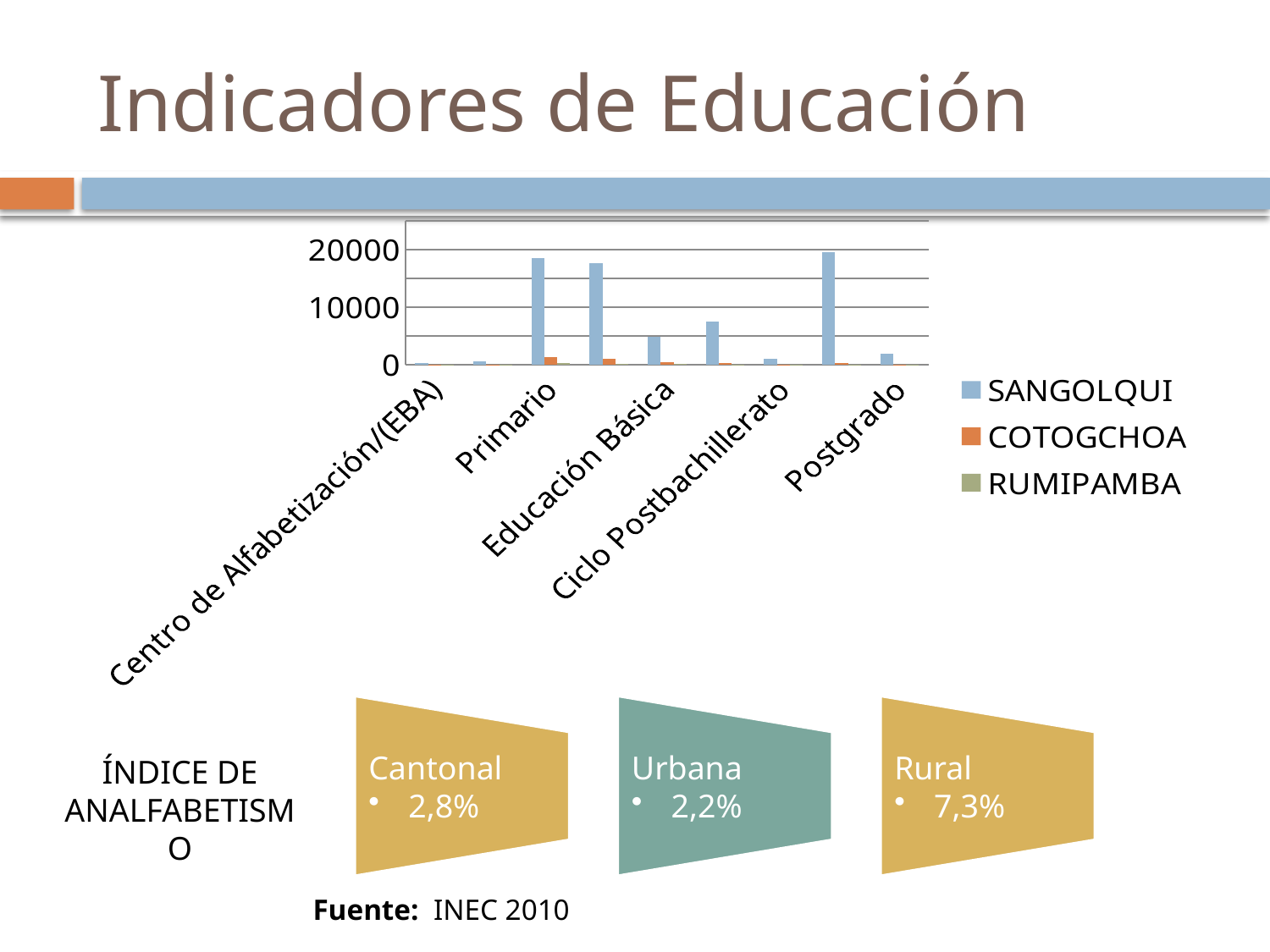
Is the SANGOLQUI value for Ciclo Postbachillerato greater or less than 10000? less For SANGOLQUI, which is larger: Primario or Postgrado? Primario For SANGOLQUI, which is larger: Primario or Educación Básica? Primario Is the SANGOLQUI value for Postgrado greater or less than 10000? less What kind of chart is shown on the slide? bar chart How many series does the chart legend list? 3 Which series is shown in blue in the chart? SANGOLQUI Is the SANGOLQUI value for Primario greater or less than 10000? greater For Primario, which series has the larger value: SANGOLQUI or COTOGCHOA? SANGOLQUI Which series are listed in the chart legend? SANGOLQUI, COTOGCHOA, RUMIPAMBA